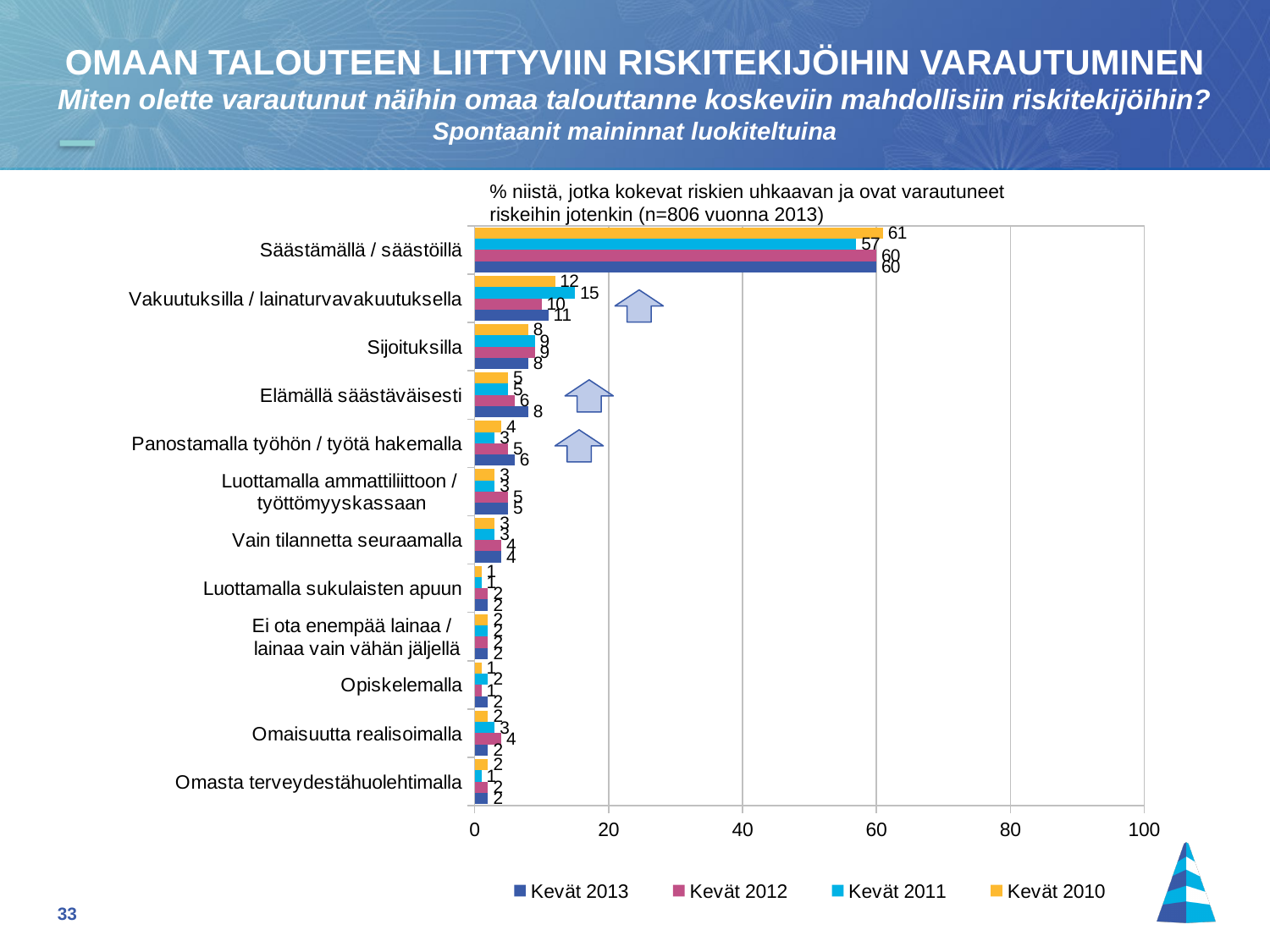
What is the value for Elämällä säästäväisesti in Kevät 2013? 8 Which is larger for Vakuutuksilla / lainaturvavakuutuksella: the Kevät 2011 value or the Kevät 2012 value? Kevät 2011 What is the value for Säästämällä / säästöillä in Kevät 2013? 60 Which series is shown in the legend first? Kevät 2013 What is the difference between the Kevät 2010 and Kevät 2011 values for Säästämällä / säästöillä? 4 What is the value for Panostamalla työhön / työtä hakemalla in Kevät 2012? 5 Which category has the highest value in Kevät 2013? Säästämällä / säästöillä How many series does the legend list? 4 How many categories are shown on the chart? 12 Is the Kevät 2012 value for Säästämällä / säästöillä greater or less than 40? greater What is the value for Vakuutuksilla / lainaturvavakuutuksella in Kevät 2011? 15 What kind of chart is shown on the slide? bar chart